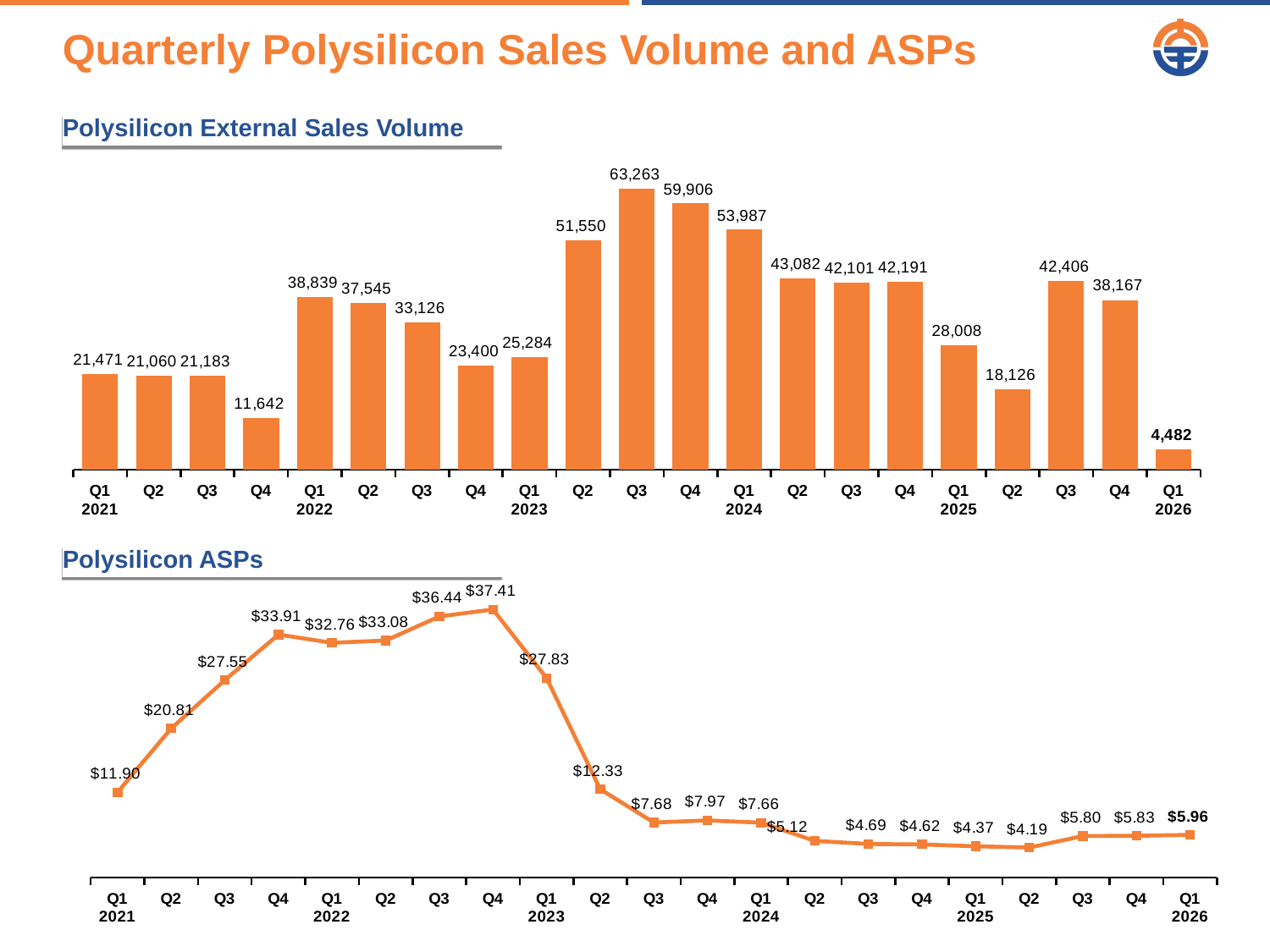
On the Polysilicon External Sales Volume chart, which quarter has the highest sales volume? Q3 2023 On the Polysilicon External Sales Volume chart, what is the difference between Q3 2023 and Q4 2023? 3,357 On the Polysilicon ASPs chart, what is the ASP for Q4 2022? $37.41 What kind of chart is the Polysilicon External Sales Volume chart? Bar chart On the Polysilicon External Sales Volume chart, what is the value for Q3 2023? 63,263 On the Polysilicon External Sales Volume chart, which quarter has the lowest sales volume? Q1 2026 On the Polysilicon ASPs chart, what is the difference between Q1 2026 and Q4 2025? $0.13 On the Polysilicon ASPs chart, do ASPs rise or fall from Q1 2021 to Q4 2022? Rise On the Polysilicon ASPs chart, which quarter has the lowest ASP? Q2 2025 How many quarters are plotted on the Polysilicon External Sales Volume chart? 21 On the Polysilicon External Sales Volume chart, which is larger, Q1 2022 or Q2 2022? Q1 2022 On the Polysilicon External Sales Volume chart, what is the value for Q1 2026? 4,482